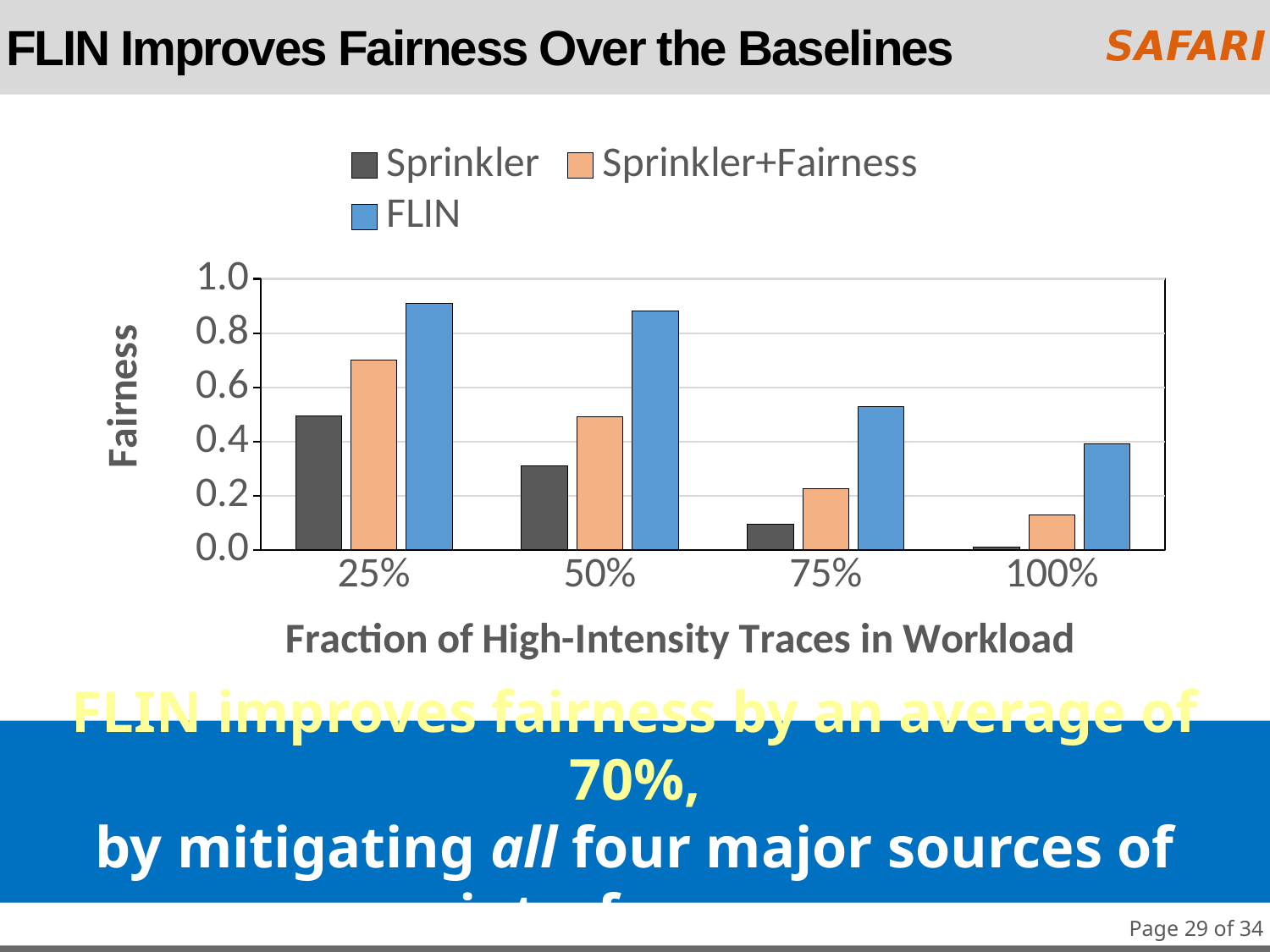
Is the FLIN fairness at 25% greater or less than 0.8? greater At which fraction of high-intensity traces is the FLIN fairness highest? 25% How many series does the legend list? 3 Is the Sprinkler fairness at 50% greater or less than 0.4? less Does the FLIN fairness rise or fall as the fraction of high-intensity traces increases from 25% to 100%? fall Which series has the highest fairness at the 25% fraction of high-intensity traces? FLIN At which fraction of high-intensity traces is the Sprinkler fairness lowest? 100% What kind of chart is shown on the slide? bar chart What is the label of the y axis? Fairness Which is larger at the 50% fraction: the fairness of FLIN or of Sprinkler? FLIN Is the Sprinkler+Fairness fairness at 75% greater or less than 0.4? less How many categories are shown on the x axis? 4